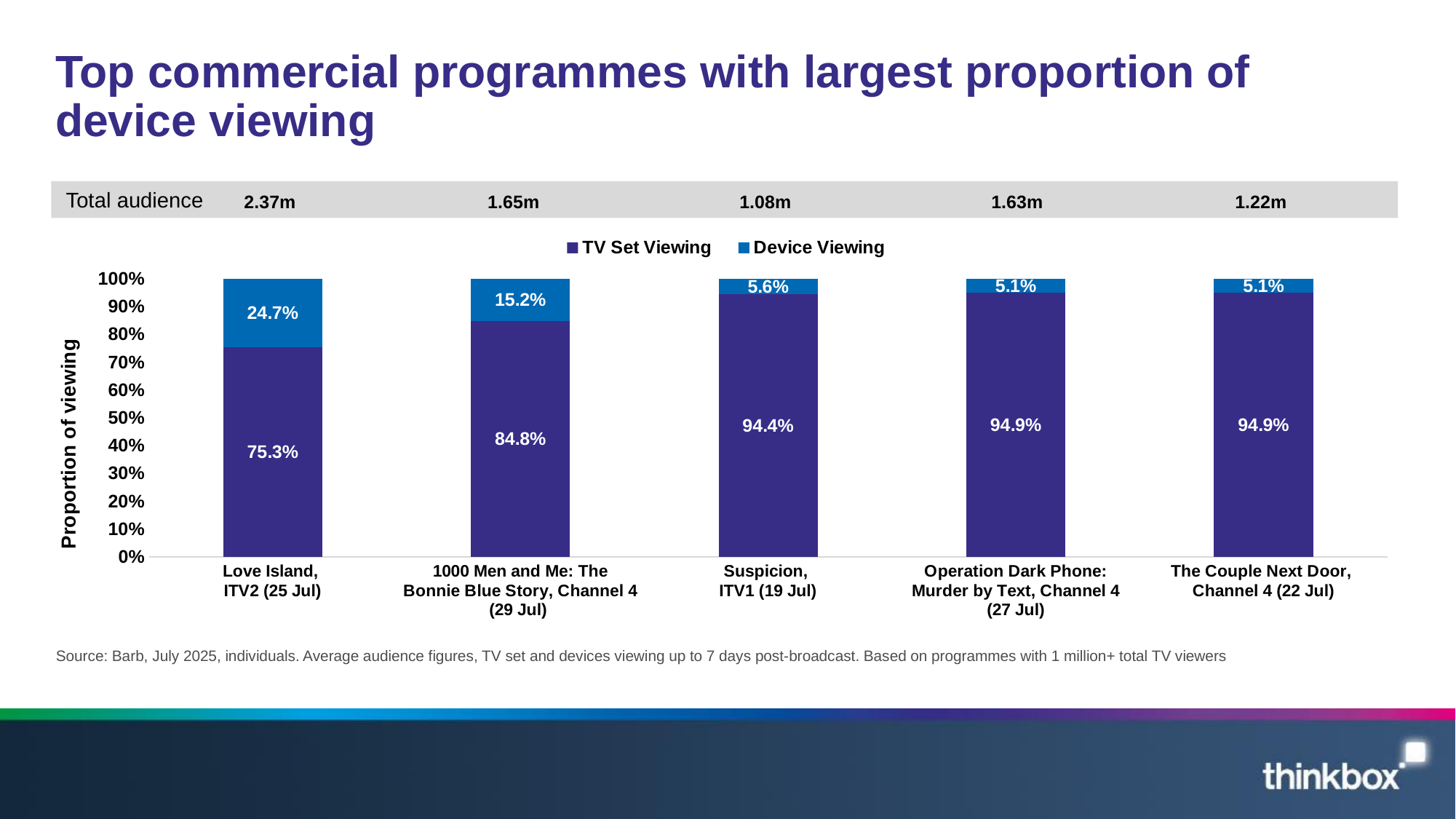
What kind of chart is shown on the slide? Stacked bar chart Which has a larger Device Viewing share, Suspicion or Operation Dark Phone: Murder by Text? Suspicion How many programmes are shown on the chart? 5 What is the Device Viewing share for Love Island, ITV2 (25 Jul)? 24.7% What is the difference between the Device Viewing shares of Love Island and 1000 Men and Me: The Bonnie Blue Story? 9.5% Which programme has the highest Device Viewing share? Love Island, ITV2 (25 Jul) What is the Device Viewing share for Suspicion, ITV1 (19 Jul)? 5.6% Which programme has the lowest TV Set Viewing share? Love Island, ITV2 (25 Jul) How many series does the legend list? 2 What is the total audience shown for Suspicion, ITV1 (19 Jul)? 1.08m What is the TV Set Viewing share for 1000 Men and Me: The Bonnie Blue Story, Channel 4 (29 Jul)? 84.8% Does the Device Viewing share rise or fall from left to right across the programmes? Fall